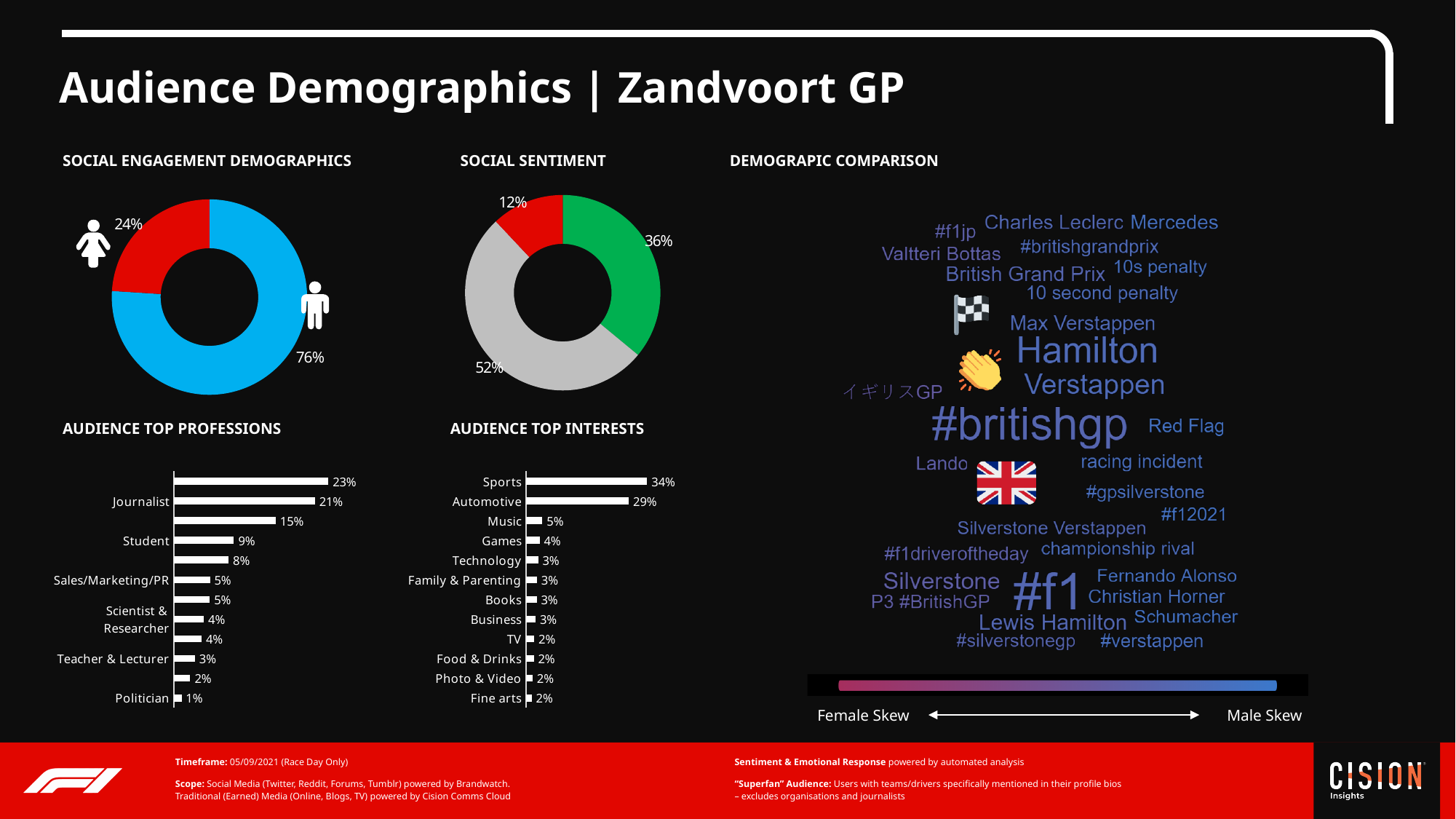
In the Social Engagement Demographics chart, what is the difference between the male and female shares? 52 percentage points In the Social Engagement Demographics chart, what percentage of the audience is female? 24% In the Audience Top Interests chart, what is the value for Automotive? 29% In the Audience Top Professions chart, which labelled profession has the lowest value? Politician In the Audience Top Professions chart, what is the value for Student? 9% How many interest categories are shown in the Audience Top Interests chart? 12 In the Social Sentiment chart, what is the value of the green slice? 36% In the Social Sentiment chart, what is the value of the largest slice? 52% In the Social Sentiment chart, what is the value of the red slice? 12% In the Audience Top Professions chart, what is the value for Journalist? 21% In the Audience Top Interests chart, what is the difference between Sports and Automotive? 5 percentage points In the Social Engagement Demographics chart, what percentage of the audience is male? 76%